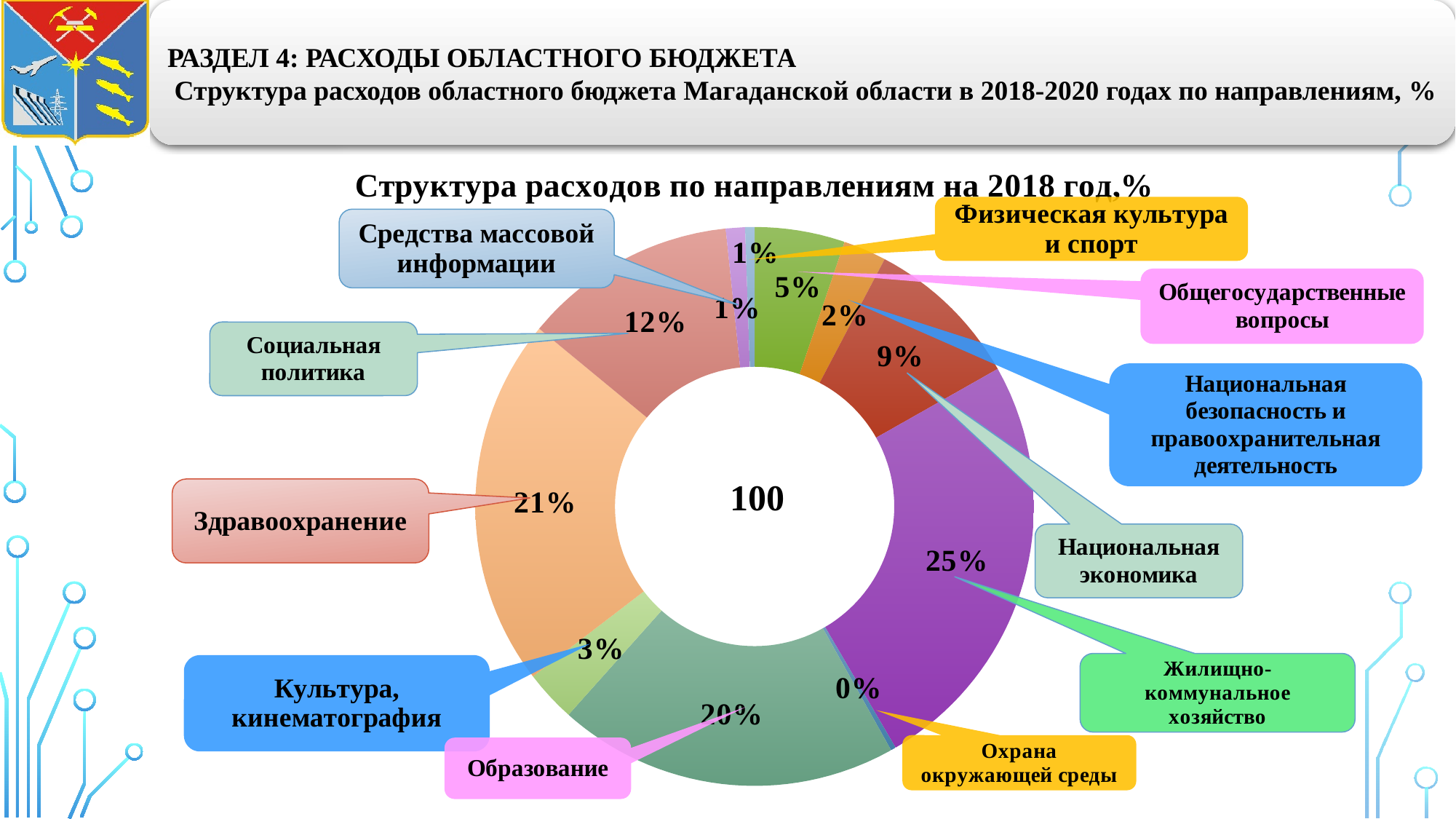
What share of expenditures is shown for Образование? 20% What share of expenditures is shown for Средства массовой информации? 1% Which category has the smallest share on the chart? Охрана окружающей среды What share of expenditures is shown for Здравоохранение? 21% What is the largest percentage value labelled on the chart? 25% What share of expenditures is shown for Культура, кинематография? 3% Which is larger, the share of Здравоохранение or the share of Социальная политика? Здравоохранение What is the difference between the shares of Здравоохранение and Образование? 1% What kind of chart is shown on the slide? Pie (doughnut) chart What is the title of the chart? Структура расходов по направлениям на 2018 год,% What share of expenditures is shown for Охрана окружающей среды? 0% What share of expenditures is shown for Социальная политика? 12%